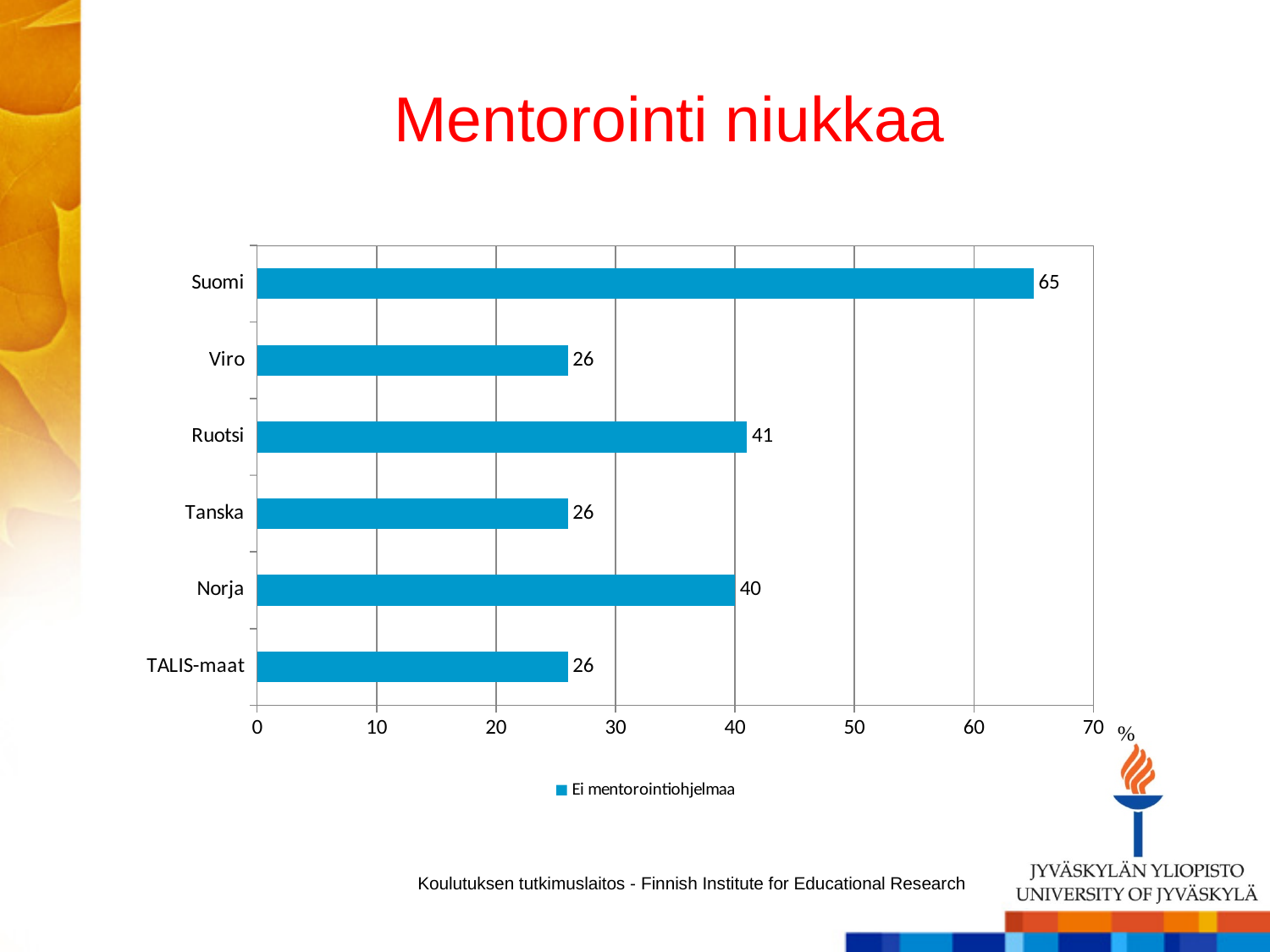
What kind of chart is shown on the slide? bar chart Which category has the highest value? Suomi What is the difference between the values for Suomi and Ruotsi? 24 What is the value for Suomi? 65 What is the value for Norja? 40 How many categories are shown on the chart? 6 What is the value for Ruotsi? 41 Which is larger, the value for Viro or the value for Ruotsi? Ruotsi Is the value for Suomi greater or less than 60? greater What is the value for TALIS-maat? 26 What is the difference between the values for Norja and Tanska? 14 How many series does the legend list? 1